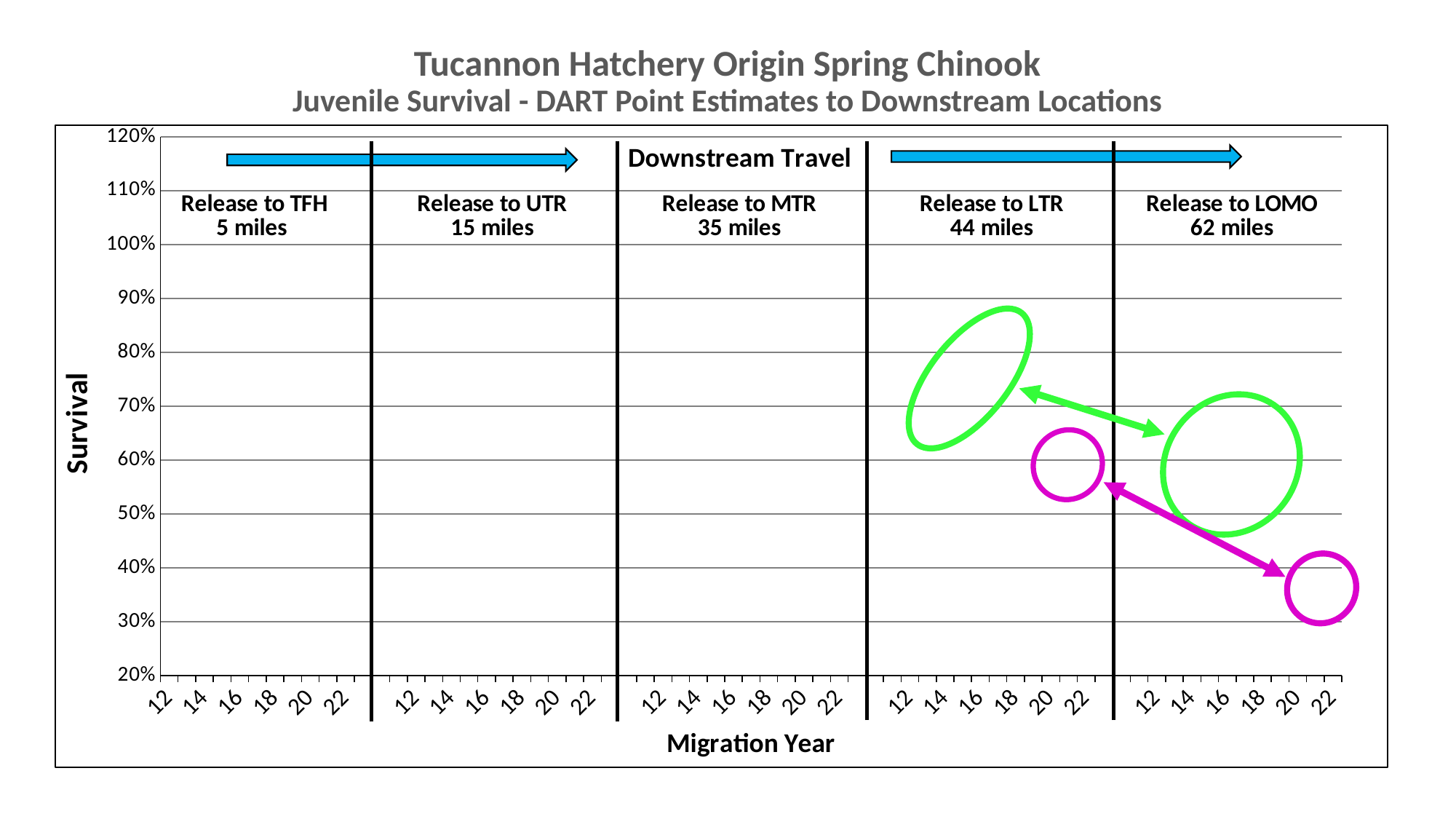
What distance is printed for the Release to MTR panel? 35 miles What is the label on the horizontal axis? Migration Year What is the label on the vertical axis? Survival Which release location panel shows the smallest distance in miles? Release to TFH How many release-location panels are shown on the chart? 5 What distance is printed for the Release to LOMO panel? 62 miles What is the difference in miles between Release to LOMO and Release to LTR? 18 miles Which is farther from release, UTR or MTR? MTR Which release location panel shows the greatest distance in miles? Release to LOMO What distance is printed for the Release to TFH panel? 5 miles